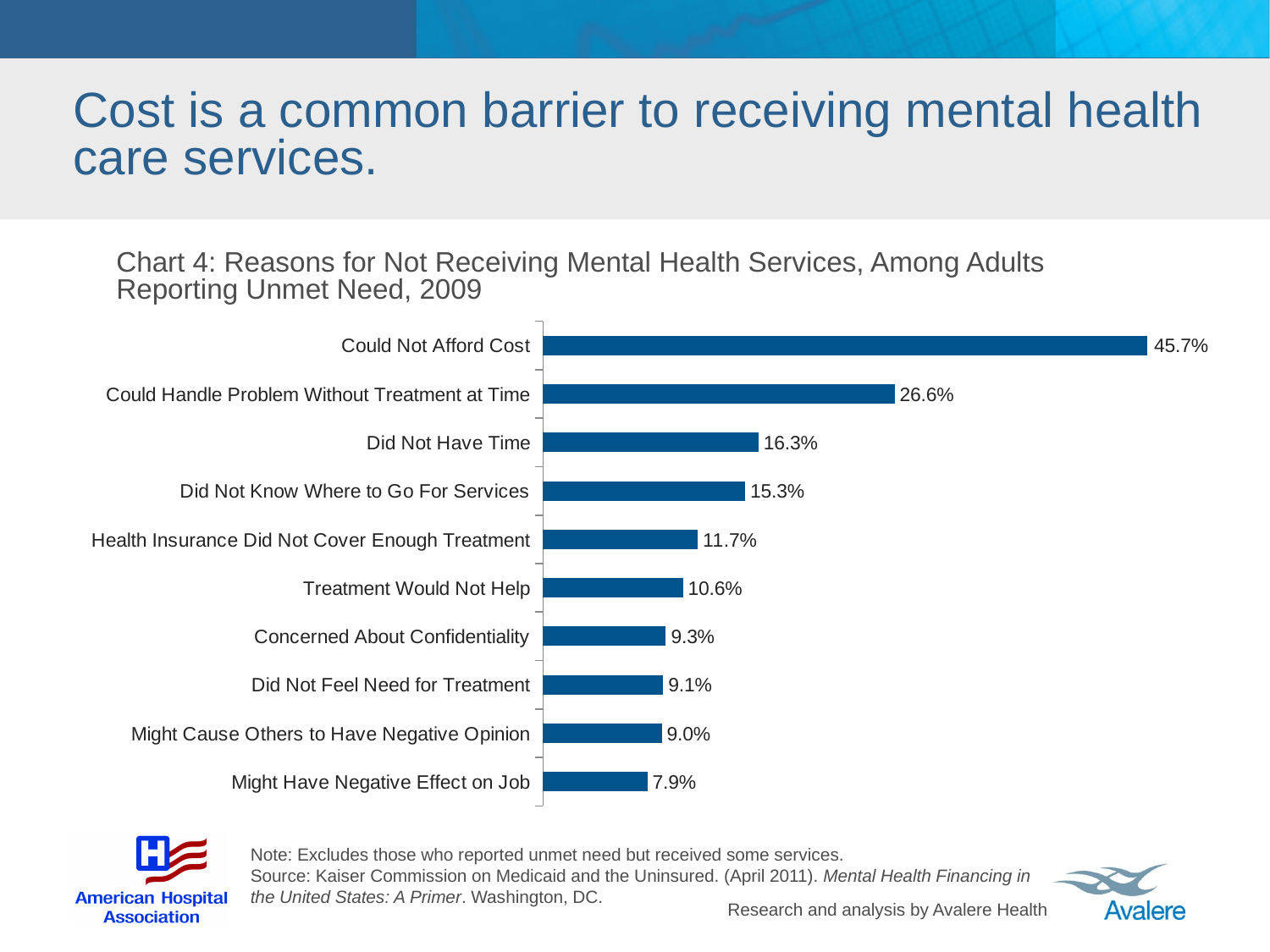
What percentage cited 'Health Insurance Did Not Cover Enough Treatment'? 11.7% Which reason has the lowest percentage? Might Have Negative Effect on Job What percentage of adults reporting unmet need said they could not afford cost? 45.7% What is the difference between 'Could Not Afford Cost' and 'Could Handle Problem Without Treatment at Time'? 19.1% What is the value for 'Did Not Know Where to Go For Services'? 15.3% What type of chart is shown on the slide? Bar chart Which is larger: 'Concerned About Confidentiality' or 'Might Have Negative Effect on Job'? Concerned About Confidentiality What is the title of the chart? Chart 4: Reasons for Not Receiving Mental Health Services, Among Adults Reporting Unmet Need, 2009 How many reasons are shown in the chart? 10 Which is larger: 'Did Not Have Time' or 'Health Insurance Did Not Cover Enough Treatment'? Did Not Have Time Which reason has the highest percentage? Could Not Afford Cost What is the difference between 'Did Not Have Time' and 'Treatment Would Not Help'? 5.7%